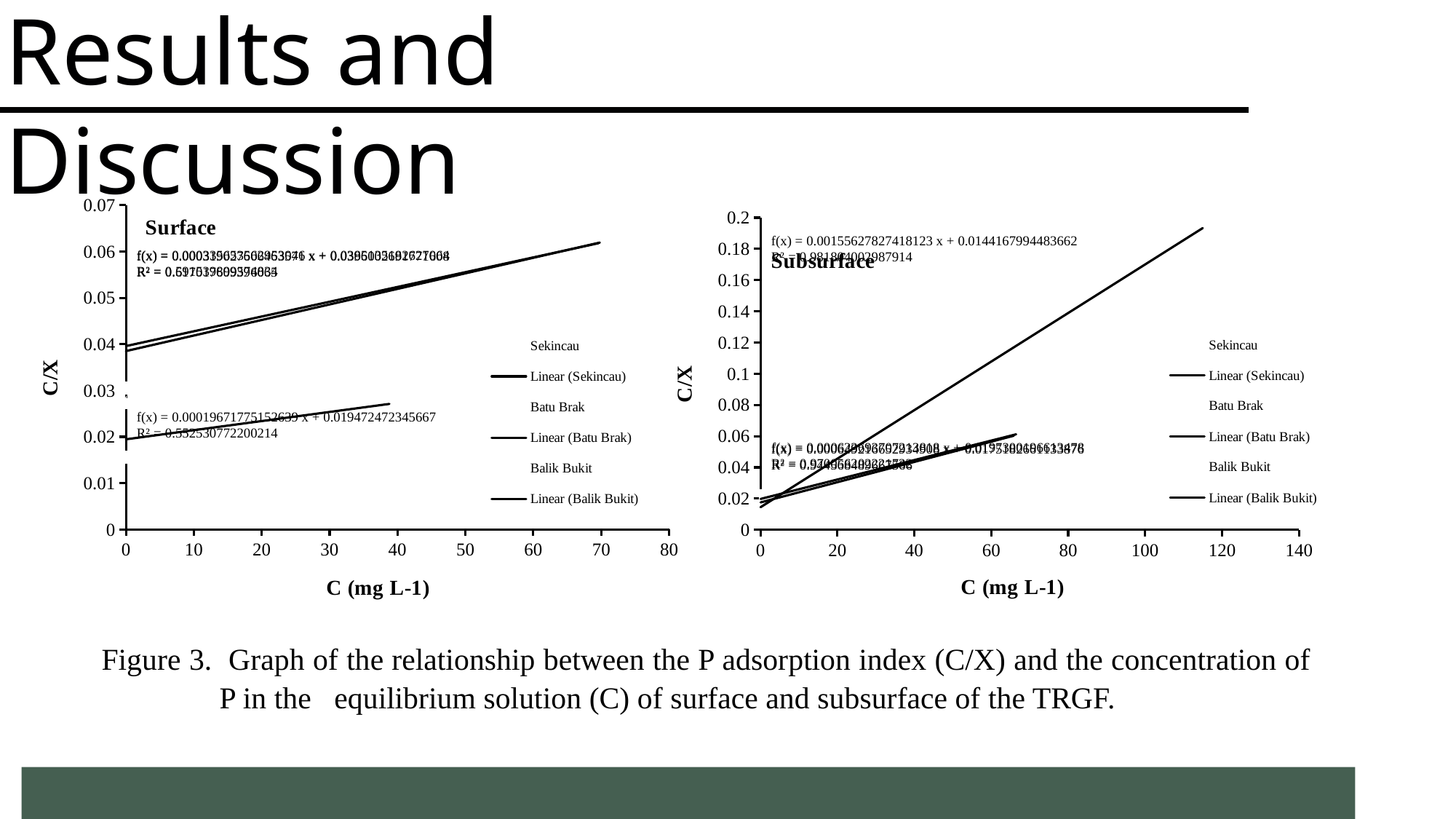
In the Surface chart, what is the title of the y axis? C/X How many charts are shown on the slide? 2 Which chart has the larger maximum value on its y axis, Surface or Subsurface? Subsurface In the Surface chart, how many entries does the legend list? 6 In the Subsurface chart, what is the title of the x axis? C (mg L-1) In the Surface chart, what is the highest value shown on the x axis? 80 In the Subsurface chart, how many entries does the legend list? 6 In the Surface chart, do the trendlines rise or fall as C increases? Rise In the Subsurface chart, is the highest point reached by the steepest trendline greater or less than 0.18? greater In the Subsurface chart, do the trendlines rise or fall as C increases? Rise What kind of chart is the Surface chart on the left? Scatter chart with linear trendlines